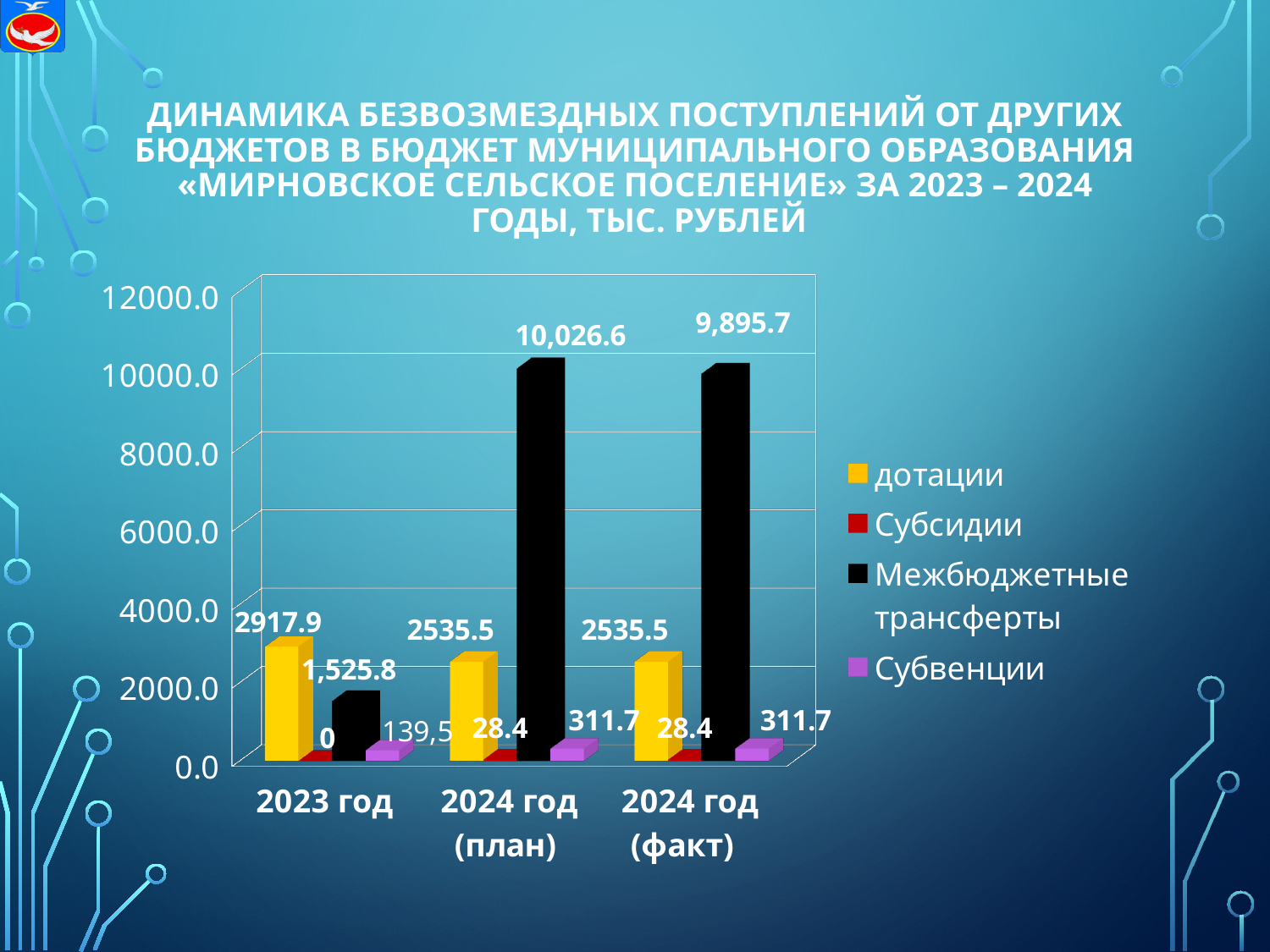
How many categories are shown on the x axis? 3 What is the value of Межбюджетные трансферты for 2024 год (факт)? 9,895.7 What is the value of Субвенции for 2023 год? 139,5 What is the difference between Межбюджетные трансферты for 2024 год (план) and 2024 год (факт)? 130.9 What type of chart is shown on the slide? bar chart Which is larger: дотации for 2023 год or дотации for 2024 год (план)? 2023 год Which series is shown in black in the legend? Межбюджетные трансферты What is the value of Субсидии for 2024 год (факт)? 28.4 What is the value of Межбюджетные трансферты for 2024 год (план)? 10,026.6 In which category is Межбюджетные трансферты the lowest? 2023 год What is the value of дотации for 2023 год? 2917.9 How many series does the legend list? 4